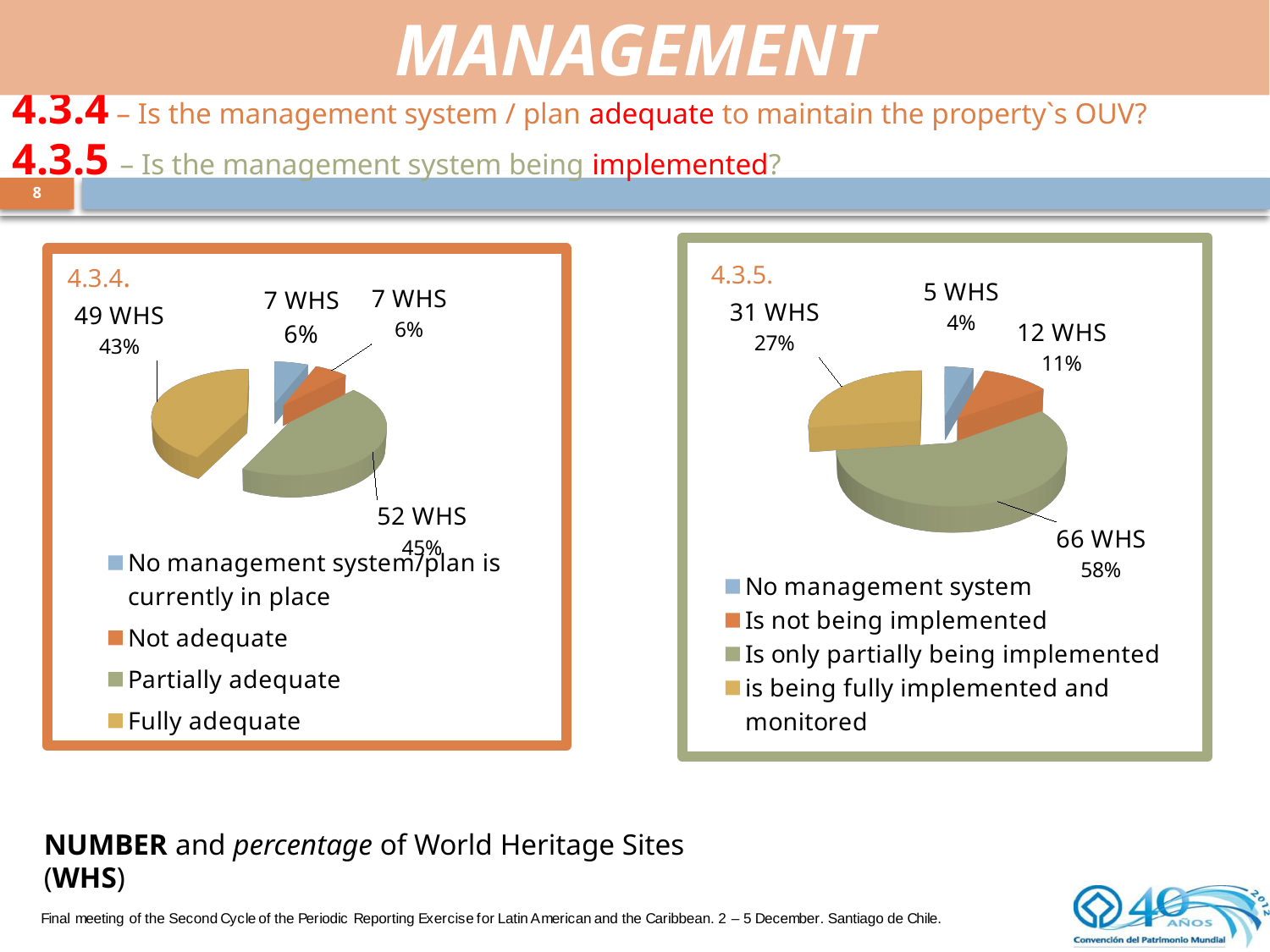
In the 4.3.5 chart, which category has the smallest share? No management system In the 4.3.4 chart, what percentage of sites are 'Fully adequate'? 43% In the 4.3.5 chart, how many WHS are in the 'Is only partially being implemented' category? 66 WHS What type of chart is used for 4.3.5? Pie chart In the 4.3.4 chart, what is the difference in number of WHS between 'Partially adequate' and 'Fully adequate'? 3 WHS In the 4.3.4 chart, how many WHS are in the 'Partially adequate' category? 52 WHS In the 4.3.5 chart, which is larger: 'Is not being implemented' or 'is being fully implemented and monitored'? is being fully implemented and monitored How many categories does the legend of the 4.3.4 chart list? 4 In the 4.3.5 chart, what is the difference in number of WHS between 'Is only partially being implemented' and 'is being fully implemented and monitored'? 35 WHS In the 4.3.5 chart, what colour represents 'Is only partially being implemented'? Green In the 4.3.5 chart, what percentage of sites have no management system? 4% In the 4.3.4 chart, which category has the largest share? Partially adequate